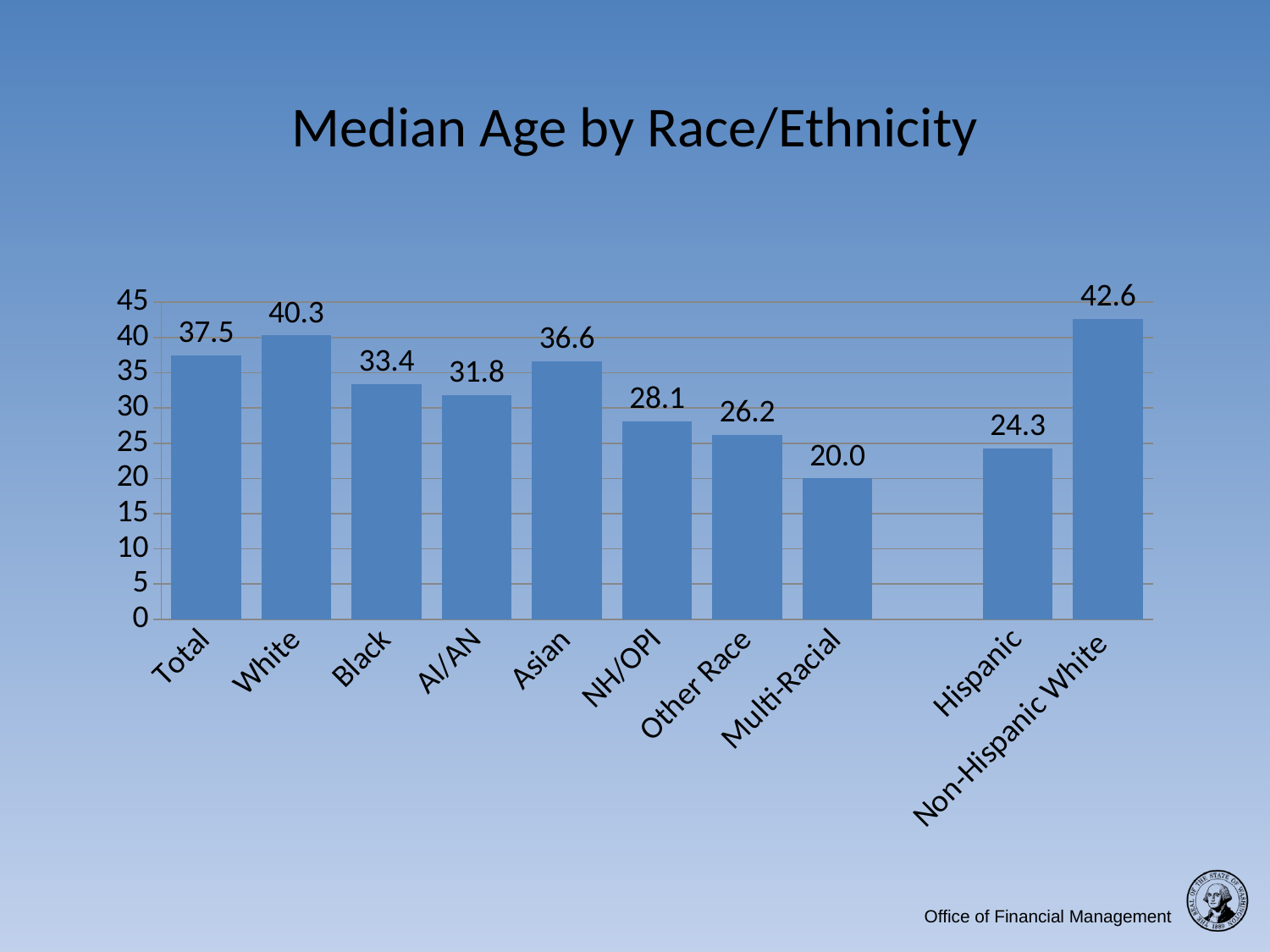
How many bars are shown in the chart? 10 What is the difference in median age between White and Black? 6.9 Which has a higher median age, NH/OPI or Other Race? NH/OPI What is the difference in median age between Non-Hispanic White and Hispanic? 18.3 Is the median age for AI/AN greater or less than 30? greater Which category has the highest median age? Non-Hispanic White What is the median age for Hispanic? 24.3 What type of chart is shown on the slide? Bar chart What is the title of the chart? Median Age by Race/Ethnicity Which category has the lowest median age? Multi-Racial What is the median age shown for the Total bar? 37.5 What is the median age for the Asian category? 36.6